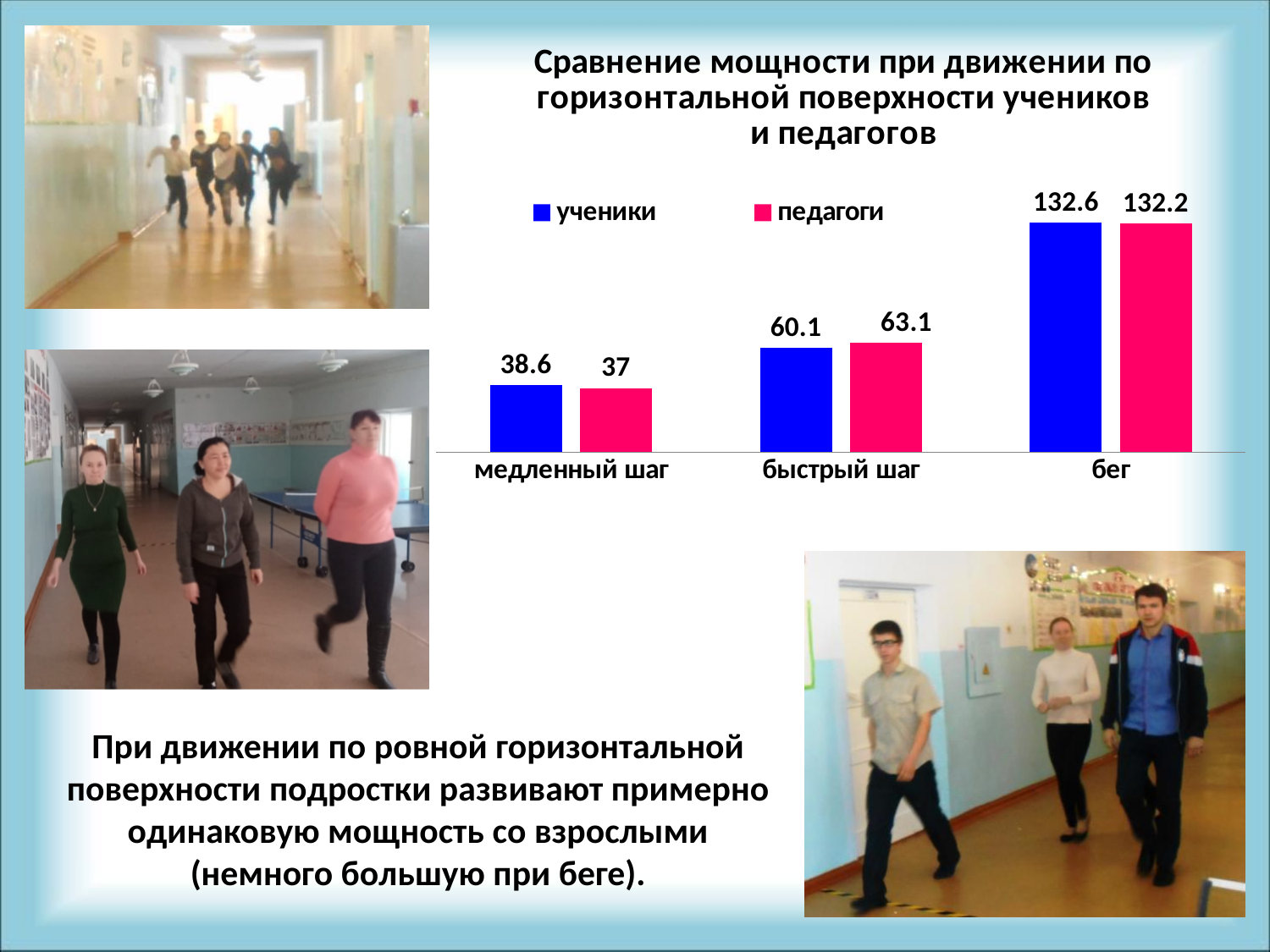
Which category has the highest value for ученики? бег Do the values for педагоги rise or fall from медленный шаг to бег? rise In the быстрый шаг category, which series has the larger value, ученики or педагоги? педагоги What kind of chart is shown on the slide? bar chart What is the difference between the ученики values for бег and быстрый шаг? 72.5 What is the value for ученики in the медленный шаг category? 38.6 What is the value for педагоги in the бег category? 132.2 Which category has the lowest value for педагоги? медленный шаг How many series does the legend list? 2 How many categories are shown on the x axis? 3 What is the difference between the ученики and педагоги values in the медленный шаг category? 1.6 What is the value for педагоги in the быстрый шаг category? 63.1